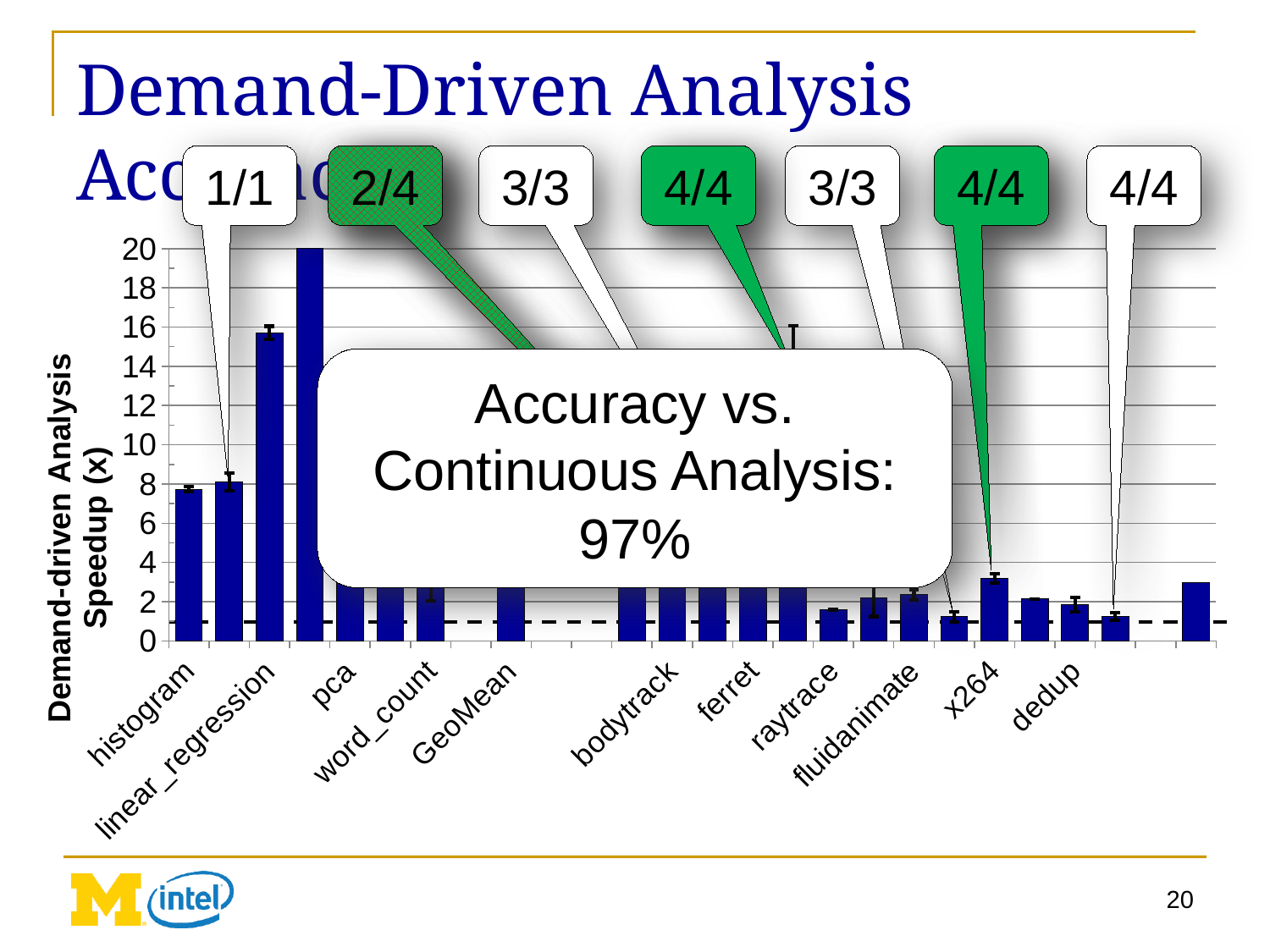
What value is shown in the first (leftmost) callout above the chart? 1/1 What is the label on the y-axis of the chart? Demand-driven Analysis Speedup (x) How many callout boxes with fractions are shown above the chart? 7 What is the highest tick value shown on the y-axis? 20 How many category labels are shown along the x-axis? 11 Is the value for dedup greater or less than 10? less What kind of chart is shown on the slide? bar chart Is the tallest bar in the chart greater or less than 18? greater Is the value for histogram greater or less than 4? greater What accuracy versus continuous analysis is stated in the overlay box on the chart? 97%